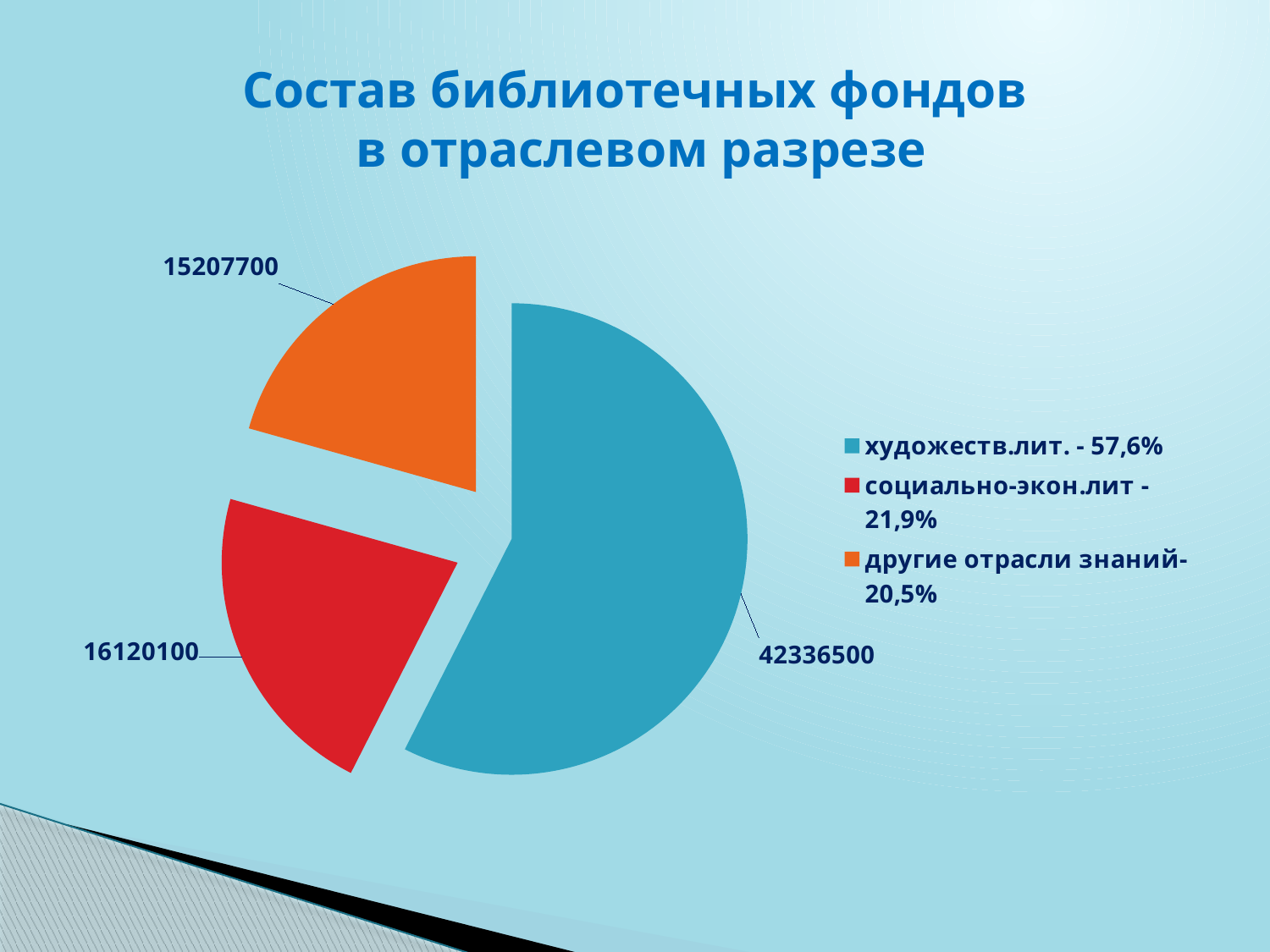
What share of the pie does художеств.лит. represent, according to the legend? 57,6% How many slices does the pie chart have? 3 Which colour represents социально-экон.лит in the pie chart? red What is the value shown for социально-экон.лит? 16120100 How many entries does the legend list? 3 What is the value shown for другие отрасли знаний? 15207700 What is the value shown for художеств.лит.? 42336500 Which category has the smallest slice of the pie? другие отрасли знаний What is the difference between the values for художеств.лит. and социально-экон.лит? 26216400 What is the title of the chart on the slide? Состав библиотечных фондов в отраслевом разрезе Which category has the largest slice of the pie? художеств.лит. What type of chart is shown on the slide? pie chart